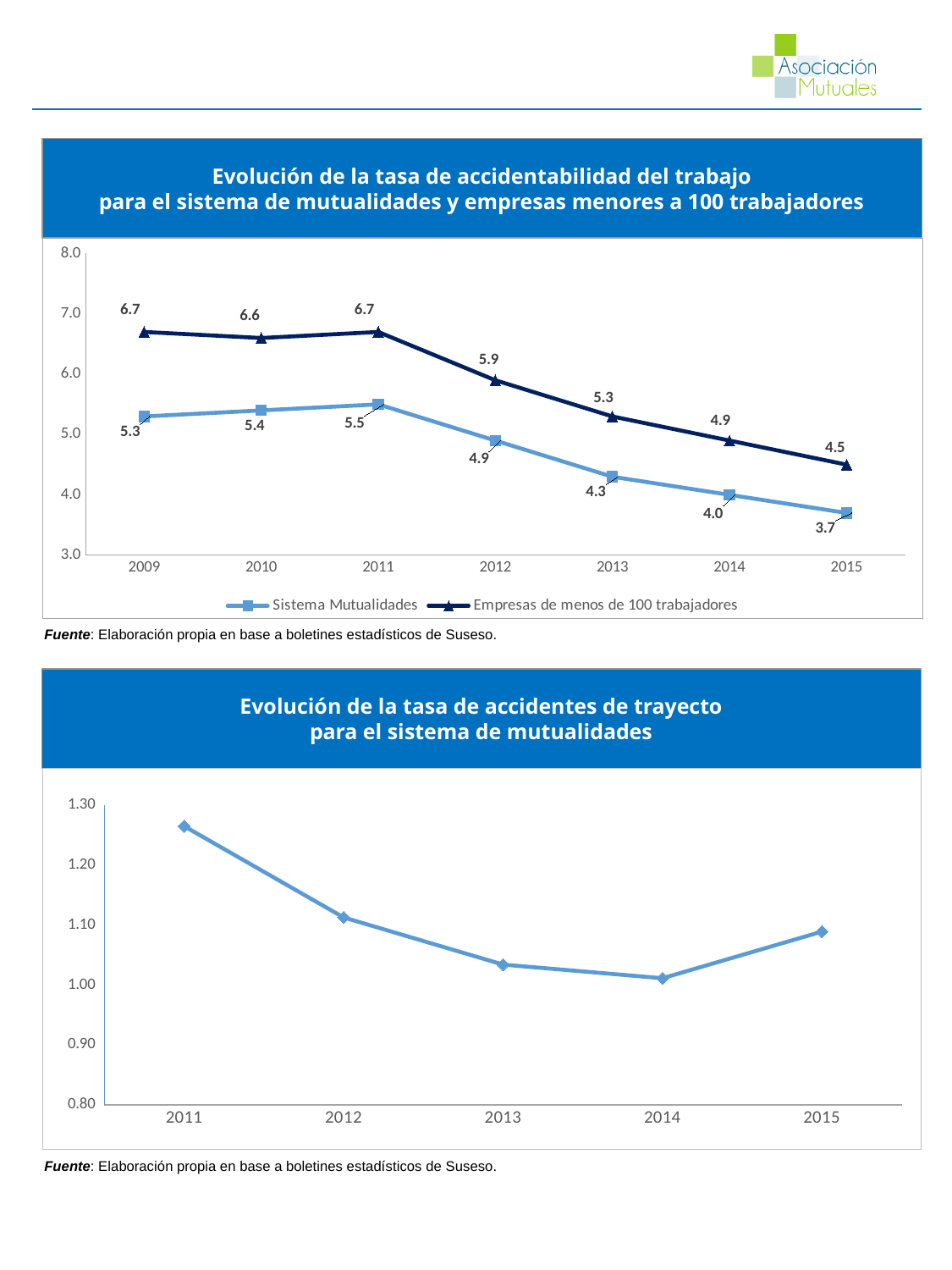
In the top chart, what is the value for Empresas de menos de 100 trabajadores in 2013? 5.3 In the bottom chart, is the value for 2011 greater or less than 1.20? greater What kind of chart is the bottom chart (Evolución de la tasa de accidentes de trayecto)? line chart In the bottom chart, in which year is the value highest? 2011 How many series does the legend of the top chart list? 2 In the bottom chart, is the value for 2014 greater or less than 1.10? less In the top chart, in which year is the Empresas de menos de 100 trabajadores series lowest? 2015 How many years are shown on the x axis of the top chart? 7 In the top chart, what is the difference between the two series in 2009? 1.4 In the top chart, in which year is the Sistema Mutualidades series highest? 2011 In the top chart (Evolución de la tasa de accidentabilidad del trabajo), what is the value for Sistema Mutualidades in 2012? 4.9 In the top chart, which series has the higher value in 2015? Empresas de menos de 100 trabajadores